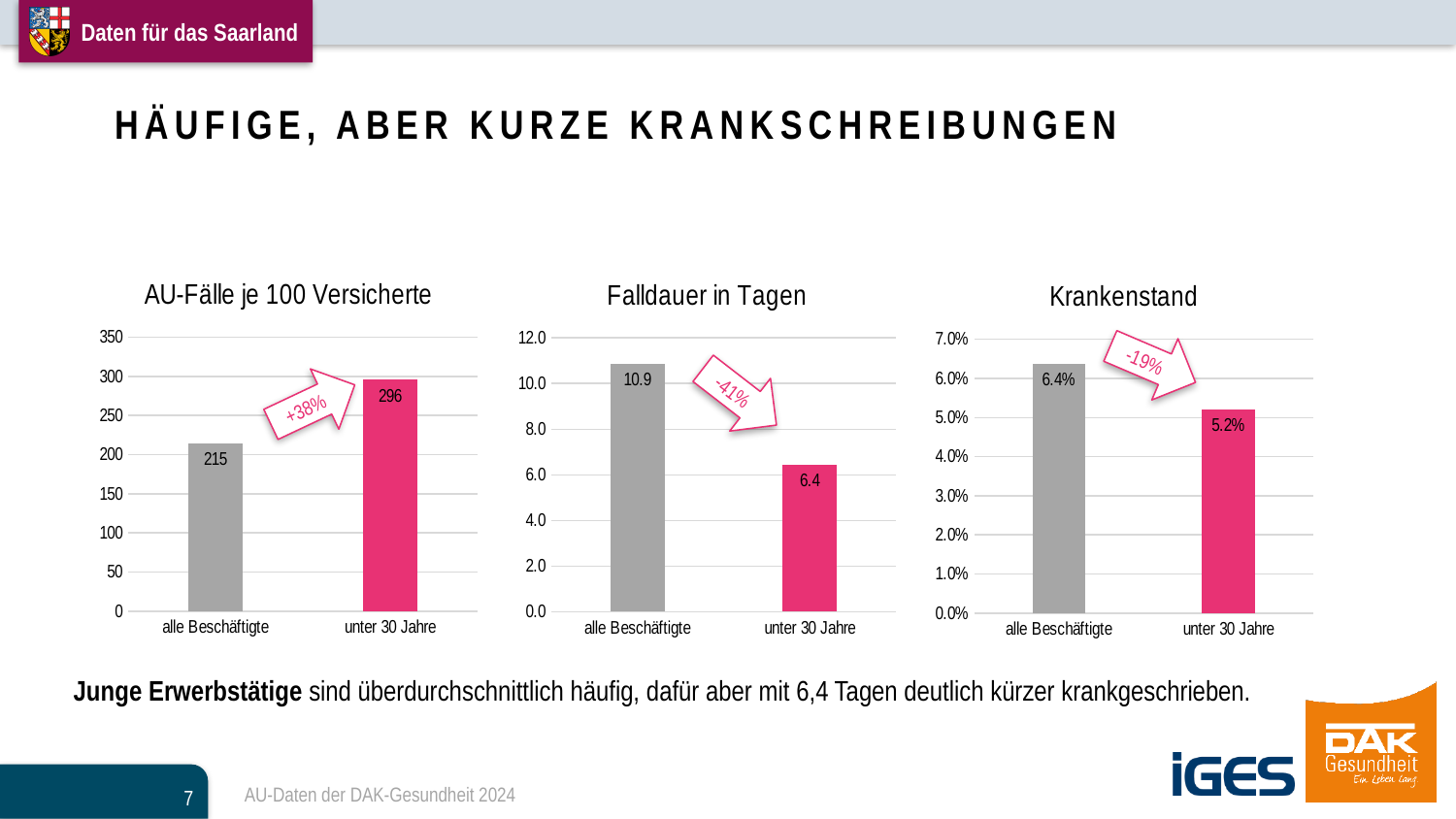
In the 'Krankenstand' chart, what is the value for 'unter 30 Jahre'? 5.2% In the 'Krankenstand' chart, which category has the higher value, 'alle Beschäftigte' or 'unter 30 Jahre'? alle Beschäftigte In the 'AU-Fälle je 100 Versicherte' chart, how many categories are shown? 2 In the 'AU-Fälle je 100 Versicherte' chart, what is the difference between 'unter 30 Jahre' and 'alle Beschäftigte'? 81 In the 'Falldauer in Tagen' chart, what is the value for 'alle Beschäftigte'? 10.9 What percentage change is shown in the arrow on the 'Krankenstand' chart? -19% In the 'Krankenstand' chart, what is the value for 'alle Beschäftigte'? 6.4% In the 'AU-Fälle je 100 Versicherte' chart, what is the value for 'unter 30 Jahre'? 296 In the 'Falldauer in Tagen' chart, which category has the lowest value? unter 30 Jahre In the 'Falldauer in Tagen' chart, what is the value for 'unter 30 Jahre'? 6.4 In the 'AU-Fälle je 100 Versicherte' chart, what is the value for 'alle Beschäftigte'? 215 What type of chart is the 'Falldauer in Tagen' chart? bar chart